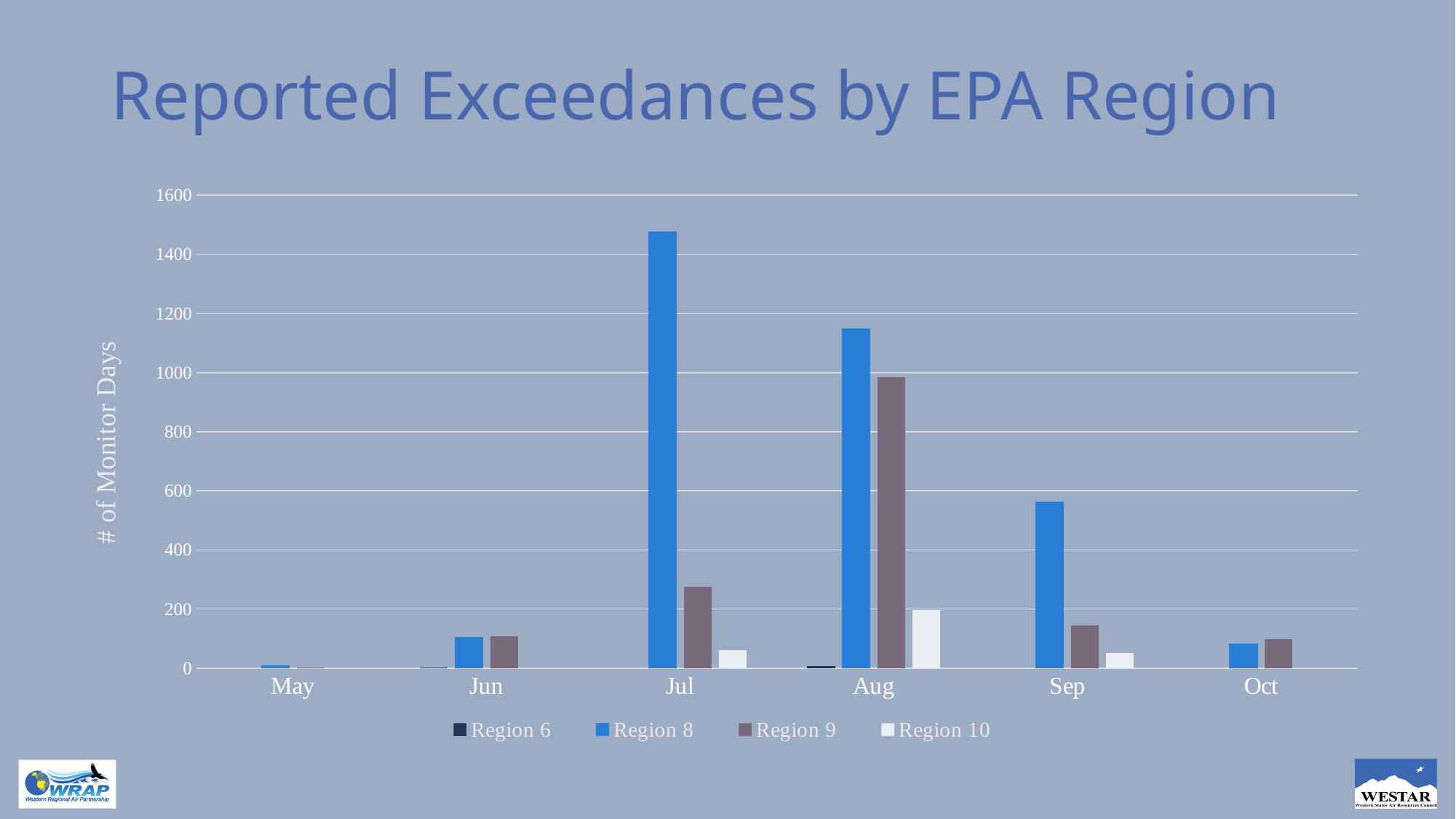
In Aug, which is larger: Region 8 or Region 9? Region 8 In Jul, which is larger: Region 9 or Region 10? Region 9 How many months are shown on the x axis? 6 In which month is the Region 8 bar the highest? Jul In which month is the Region 9 bar the highest? Aug Is the value for Region 9 in Aug greater or less than 800? greater How many series does the legend list? 4 What kind of chart is shown on the slide? Bar chart Is the value for Region 8 in Jul greater or less than 1400? greater What is the label on the y axis? # of Monitor Days Is the value for Region 8 in Sep greater or less than 600? less